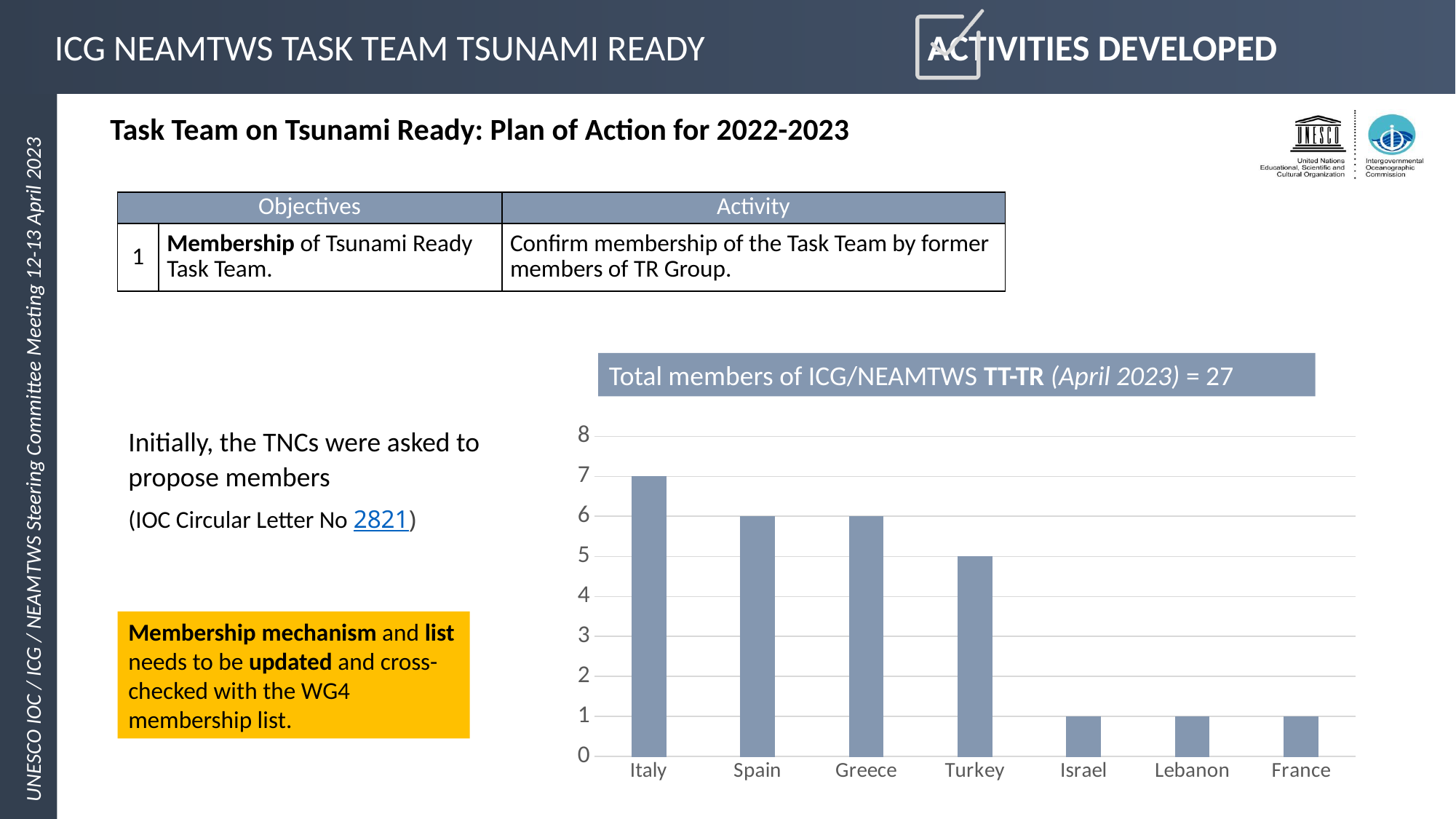
What is the value for Lebanon in the bar chart? 1 According to the chart heading, what is the total number of members of ICG/NEAMTWS TT-TR in April 2023? 27 Do the values generally rise or fall from Italy to France along the x axis? fall What is the difference between the values for Italy and Turkey? 2 Which is larger, the value for Spain or the value for Turkey? Spain How many countries are shown in the bar chart? 7 What kind of chart is shown on the slide? bar chart Which country has the highest value in the bar chart? Italy What is the value for Italy in the bar chart? 7 What is the difference between the values for Spain and Israel? 5 What is the value for Turkey in the bar chart? 5 Is the value for Italy greater or less than 5? greater